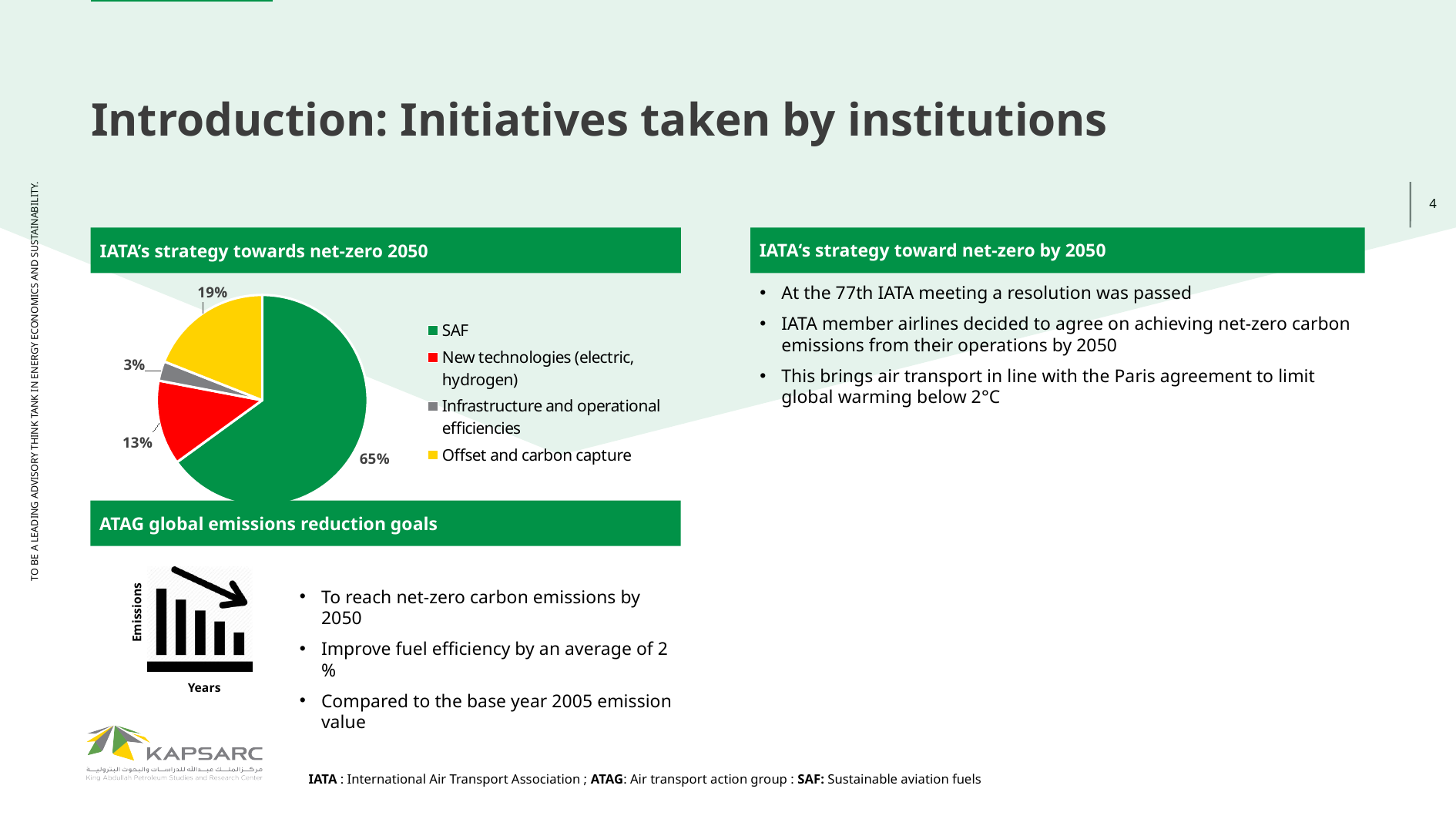
What percentage is shown for New technologies (electric, hydrogen) in the pie chart? 13% How many categories does the pie chart's legend list? 4 Which category has the largest slice in the pie chart? SAF Which category has the smallest slice in the pie chart? Infrastructure and operational efficiencies Which is larger in the pie chart: Offset and carbon capture or New technologies (electric, hydrogen)? Offset and carbon capture What is the difference in percentage points between the SAF slice and the Offset and carbon capture slice? 46 What percentage is shown for Offset and carbon capture in the pie chart? 19% What colour represents SAF in the pie chart? Green What colour represents Offset and carbon capture in the pie chart? Yellow What kind of chart is shown under the heading "IATA's strategy towards net-zero 2050"? Pie chart What percentage is shown for Infrastructure and operational efficiencies in the pie chart? 3% What share of the pie chart does SAF account for? 65%